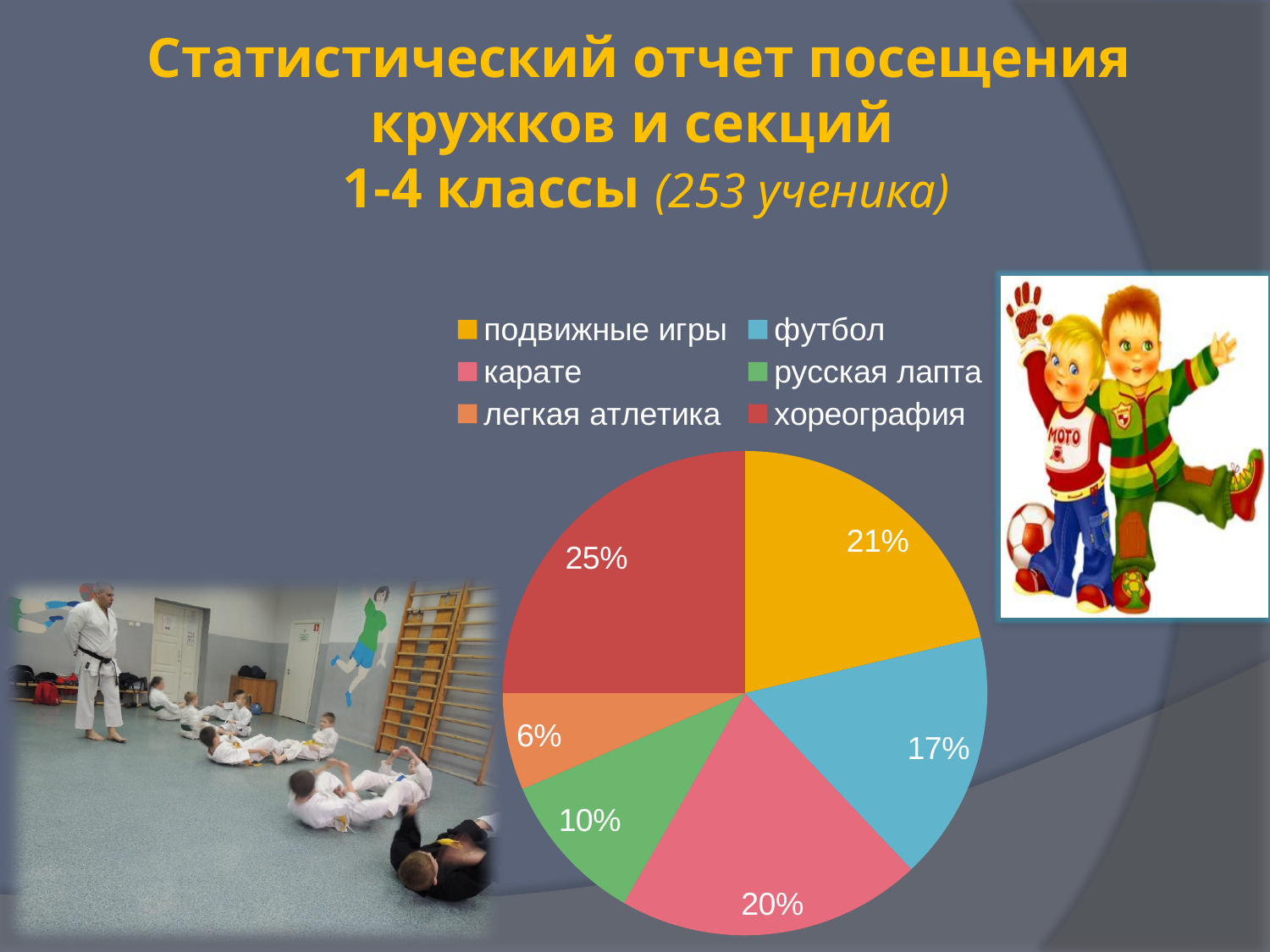
Which colour represents хореография in the pie chart? red Which has a larger share, футбол or карате? карате What share of the pie does карате have? 20% What is the difference between the shares of хореография and русская лапта? 15% How many categories does the pie chart have? 6 Which category has the largest slice of the pie? хореография What share of the pie does легкая атлетика have? 6% What share of the pie does русская лапта have? 10% What share of the pie does подвижные игры have? 21% What share of the pie does футбол have? 17% What kind of chart is shown on the slide? pie chart Which category has the smallest slice of the pie? легкая атлетика